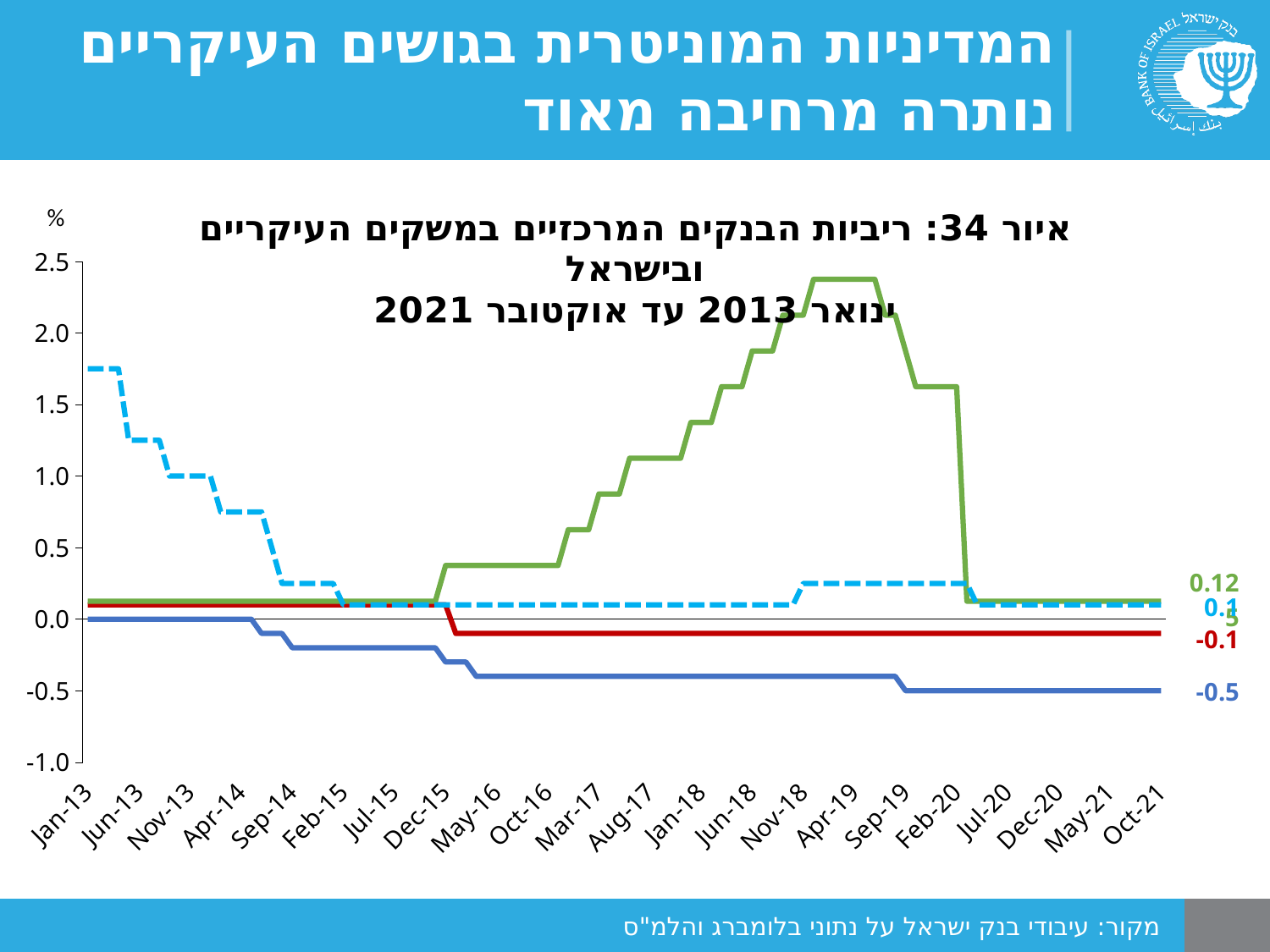
What unit is shown on the y axis? % How many lines are plotted on the chart? 4 Is the value of the dashed blue line at Jan-13 greater or less than 1.5? greater Does the solid blue line rise or fall over the period shown? fall What is the final value labelled at the end of the solid red line? -0.1 Which line reaches the highest value on the chart? the green line What is the lowest tick value shown on the y axis? -1.0 What is the final value labelled at the end of the solid blue line? -0.5 Which line ends at the lowest value in Oct-21? the solid blue line Is the peak value of the green line greater or less than 2.0? greater Does the dashed blue line rise or fall between Jan-13 and Feb-15? fall What kind of chart is shown on the slide? line chart